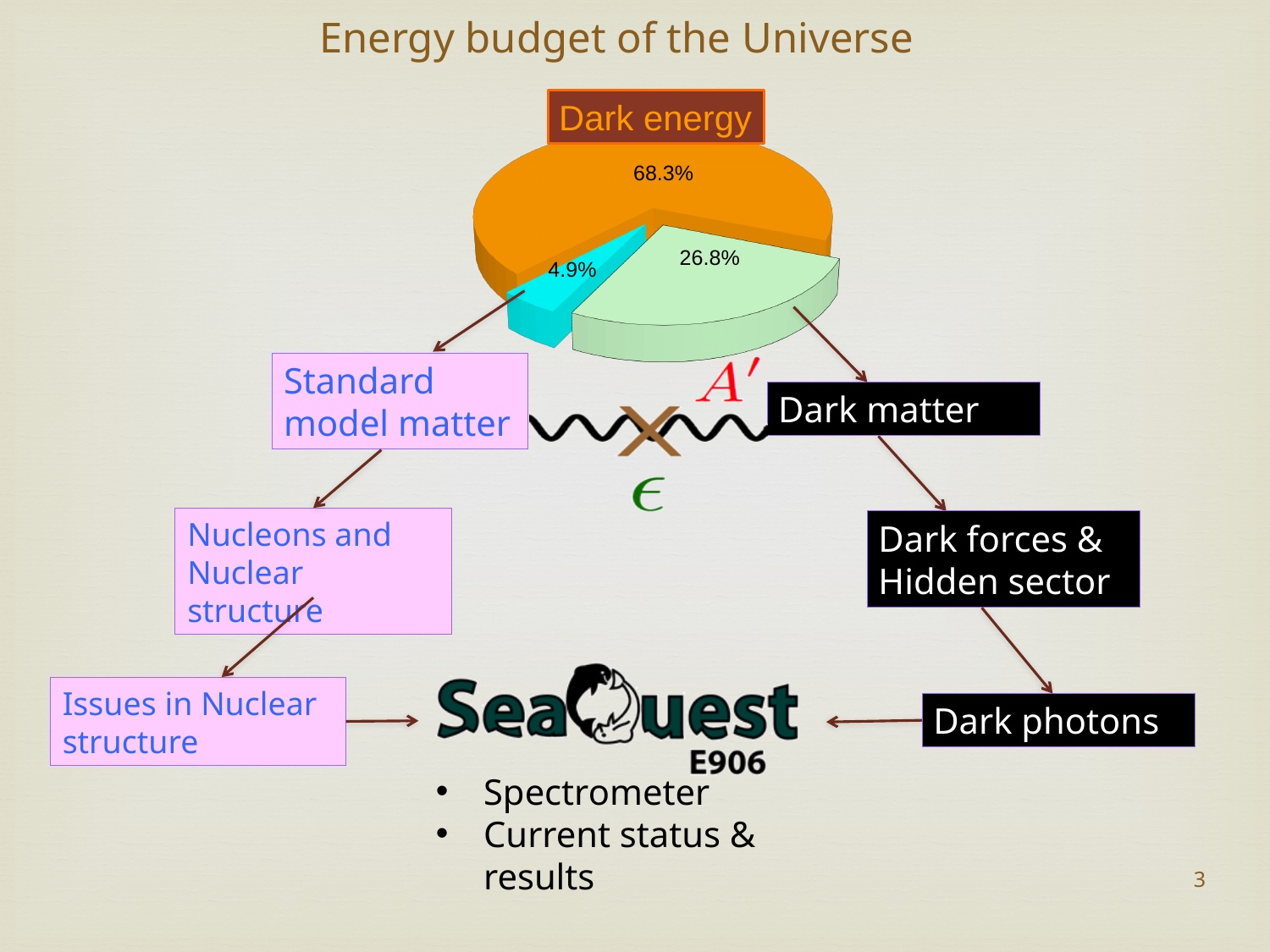
What percentage is shown for the Dark matter slice of the pie chart? 26.8% What kind of chart is shown on the slide? Pie chart Which slice of the pie chart is the largest? Dark energy What percentage of the energy budget does the Dark energy slice represent? 68.3% Which is larger in the pie chart, the Dark matter slice or the Standard model matter slice? Dark matter By how many percentage points does the Dark energy slice exceed the Dark matter slice? 41.5 percentage points What colour is the largest slice of the pie chart? Orange How many slices does the pie chart have? 3 What is the title of the slide containing the pie chart? Energy budget of the Universe Which slice of the pie chart is the smallest? Standard model matter What percentage is shown for the Standard model matter slice of the pie chart? 4.9% What is the difference in percentage points between the Dark matter slice and the Standard model matter slice? 21.9 percentage points